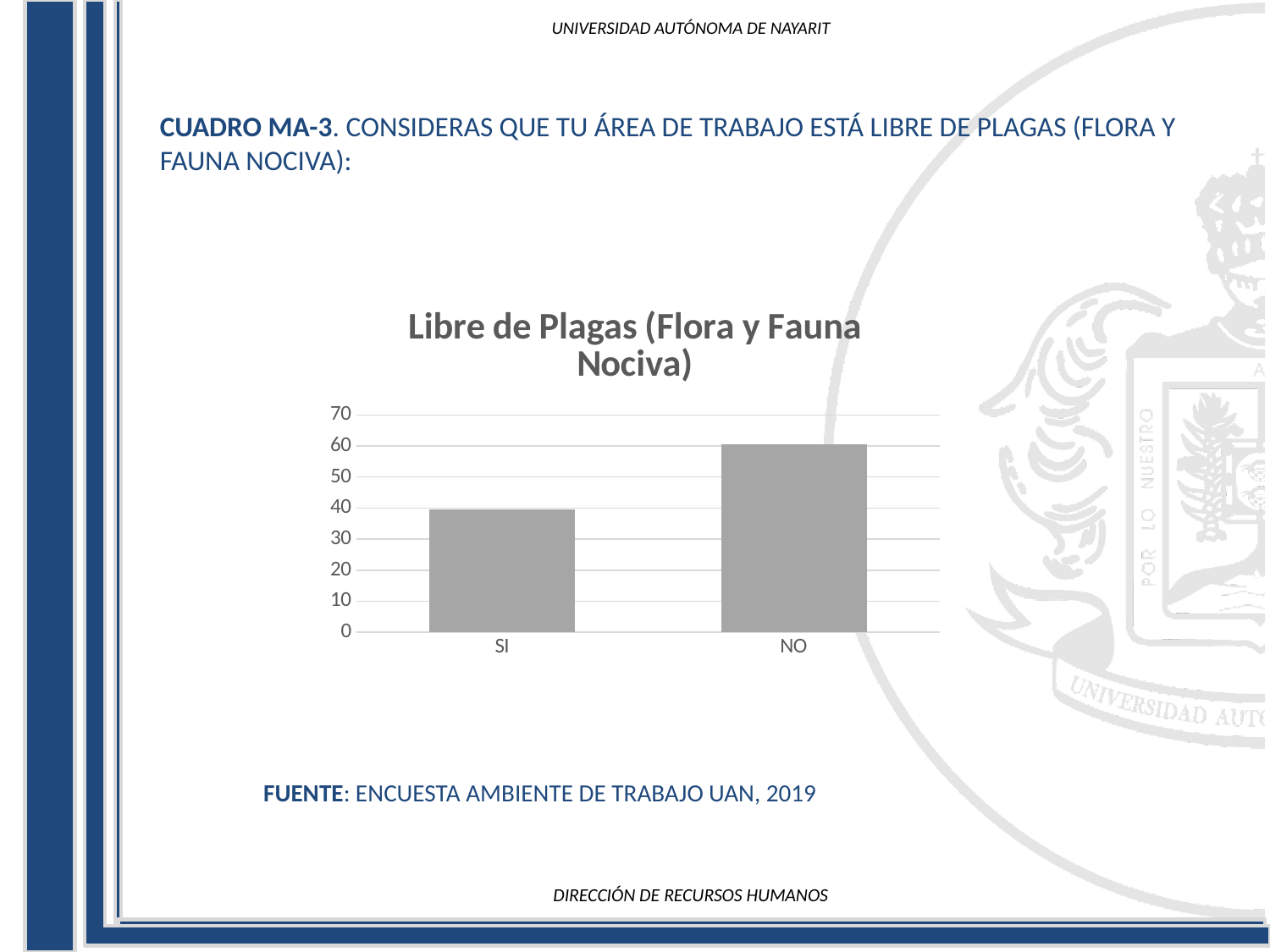
What is the title of the chart? Libre de Plagas (Flora y Fauna Nociva) Is the value for NO greater or less than 50? greater Is the value for NO greater or less than 70? less Do the values rise or fall from SI to NO along the x axis? rise Which category has the highest value in the chart? NO What is the highest value shown on the vertical axis of the chart? 70 Which is larger, the value for SI or the value for NO? NO How many categories are shown on the x axis of the chart? 2 Is the value for SI greater or less than 50? less What kind of chart is shown on the slide? bar chart Which category has the lowest value in the chart? SI